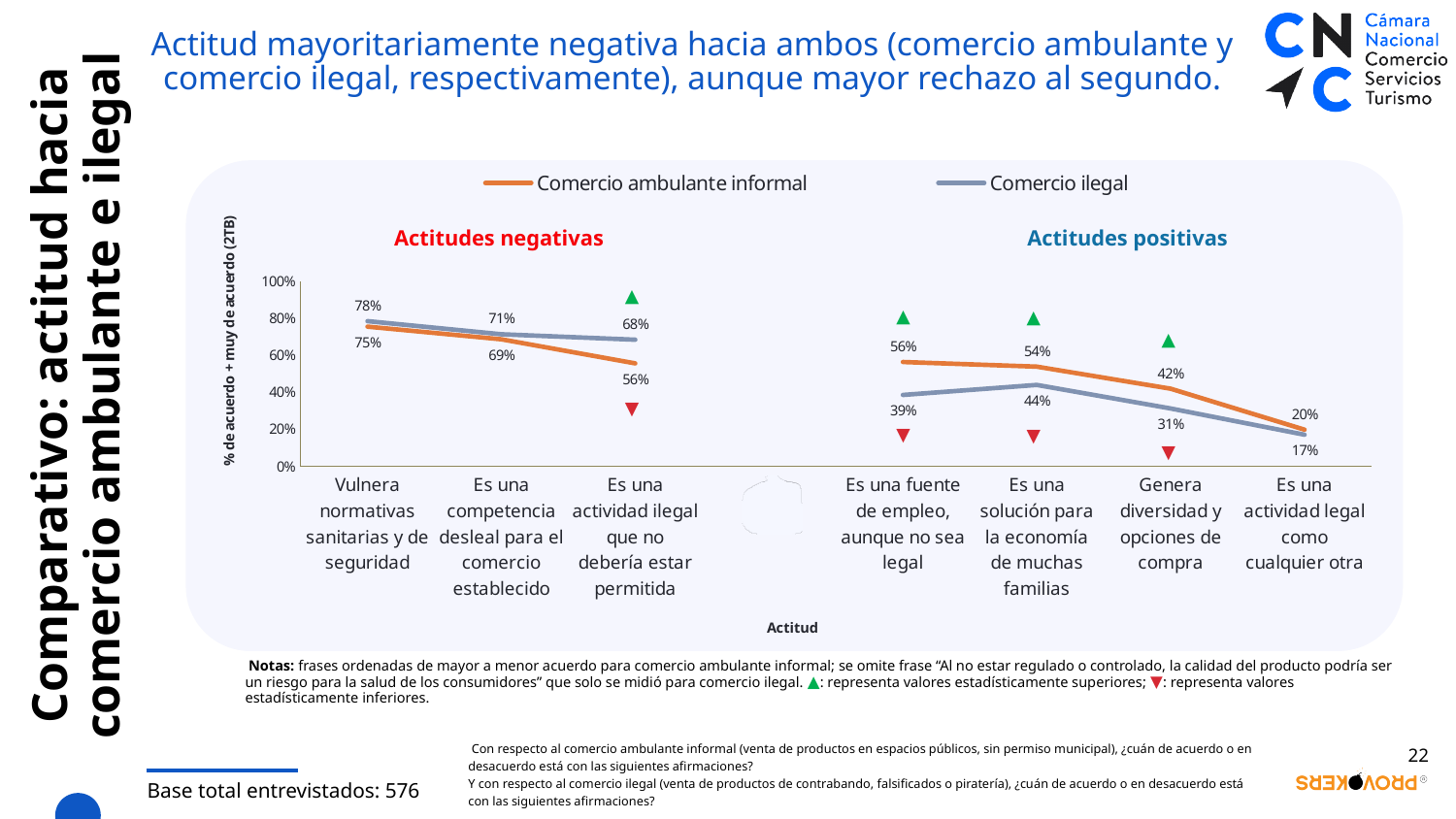
How many series does the legend list? 2 What is the value for Comercio ilegal on 'Vulnera normativas sanitarias y de seguridad'? 78% Do the values for Comercio ambulante informal rise or fall across the four positive attitude statements from left to right? Fall Which statement has the highest value for Comercio ambulante informal? Vulnera normativas sanitarias y de seguridad Which colour represents the Comercio ambulante informal series? Orange How many attitude statements (categories) are plotted along the x axis? 7 What is the value for Comercio ilegal on 'Genera diversidad y opciones de compra'? 31% What is the value for Comercio ambulante informal on 'Es una fuente de empleo, aunque no sea legal'? 56% What kind of chart is shown on the slide? Line chart On 'Es una solución para la economía de muchas familias', which series has the larger value? Comercio ambulante informal What is the difference between Comercio ilegal and Comercio ambulante informal on 'Es una actividad ilegal que no debería estar permitida'? 12% Which statement has the lowest value for Comercio ilegal? Es una actividad legal como cualquier otra